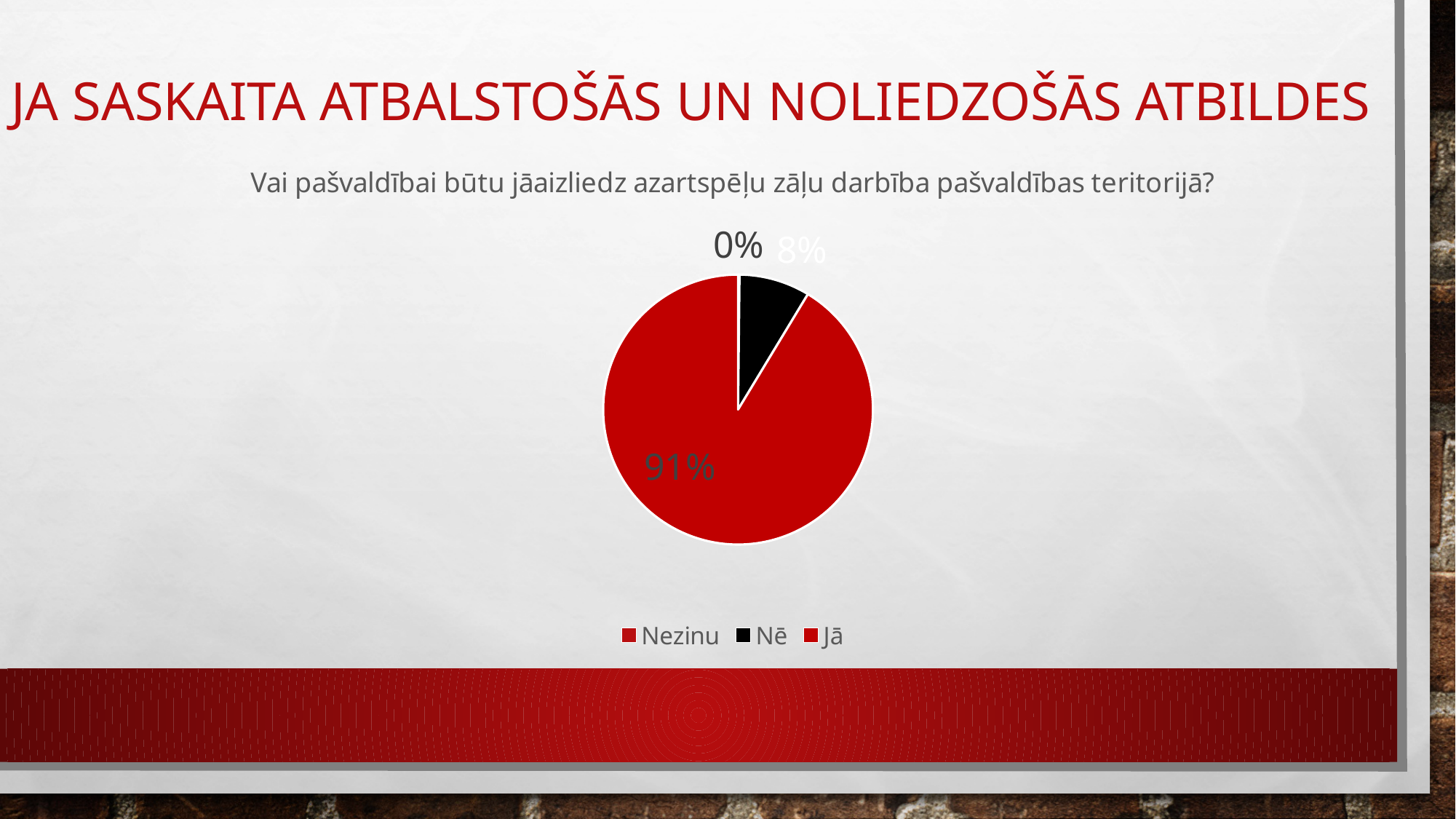
Which is larger, the "Nē" slice or the "Jā" slice? Jā What question is shown as the title of the pie chart? Vai pašvaldībai būtu jāaizliedz azartspēļu zāļu darbība pašvaldības teritorijā? What percentage is shown for the "Jā" slice of the pie? 91% Which answer category has the smallest share of the pie? Nezinu How many categories does the legend of the pie chart list? 3 What colour is the "Nē" slice of the pie? black What is the difference in percentage points between the "Jā" and "Nē" slices? 83 What kind of chart is shown on the slide? pie chart What percentage of the pie is labelled for the "Nē" slice? 8% Which answer category has the largest share of the pie? Jā What percentage is shown for the "Nezinu" slice of the pie? 0%